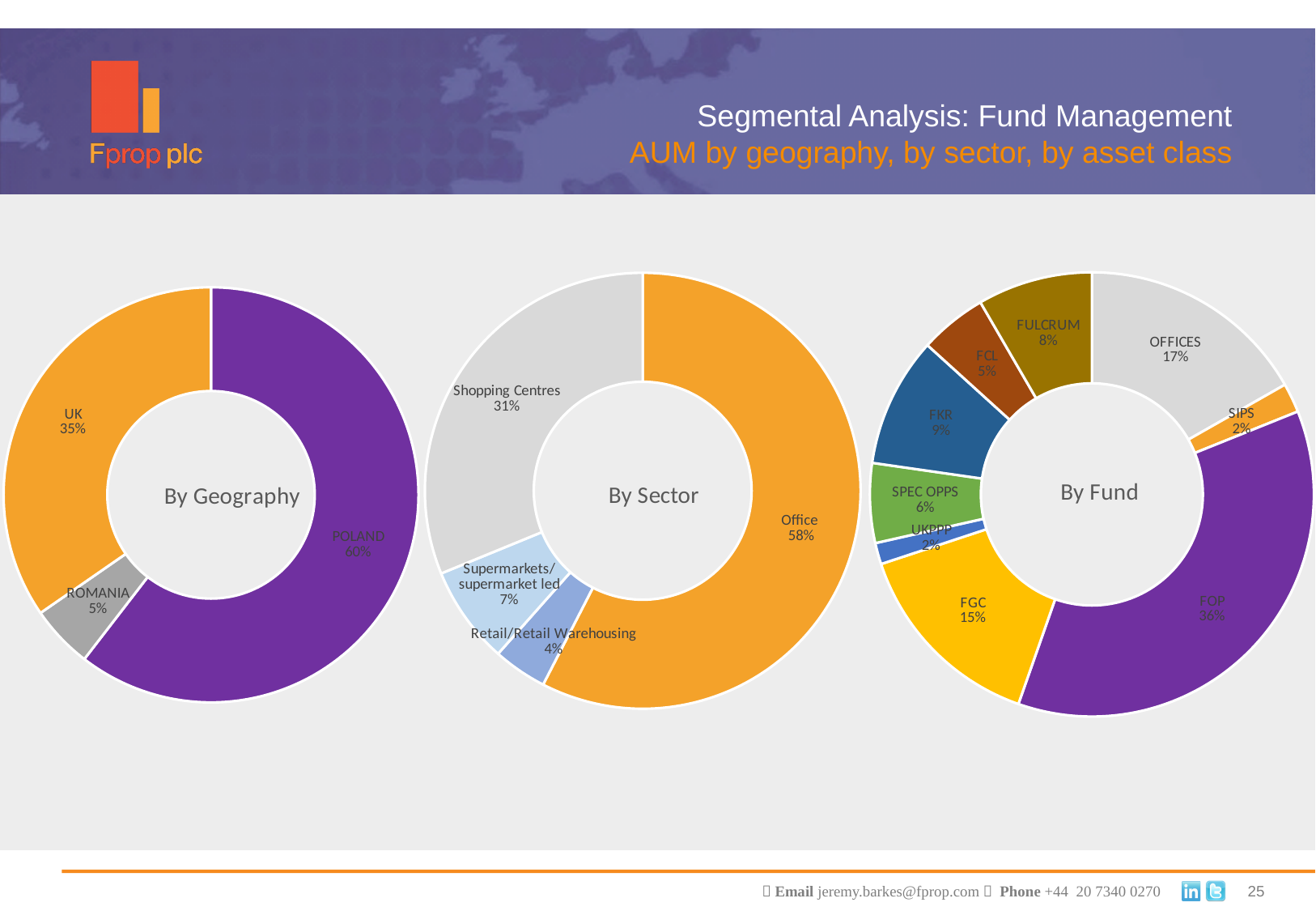
In the By Fund chart, how many funds are shown? 9 In the By Geography chart, what is the difference between the UK share and the Romania share? 30% In the By Sector chart, how many sectors are shown? 4 In the By Sector chart, which is larger, Supermarkets/supermarket led or Retail/Retail Warehousing? Supermarkets/supermarket led In the By Sector chart, which sector has the largest share? Office In the By Fund chart, what is the difference between the FOP share and the OFFICES share? 19% In the By Geography chart, what share of AUM is in Poland? 60% In the By Fund chart, what share of AUM is in FOP? 36% What kind of chart is used for the three charts on the slide? Doughnut (pie) chart In the By Geography chart, which geography has the smallest share? Romania In the By Sector chart, what share of AUM is in Office? 58% In the By Fund chart, what share of AUM is in FKR? 9%